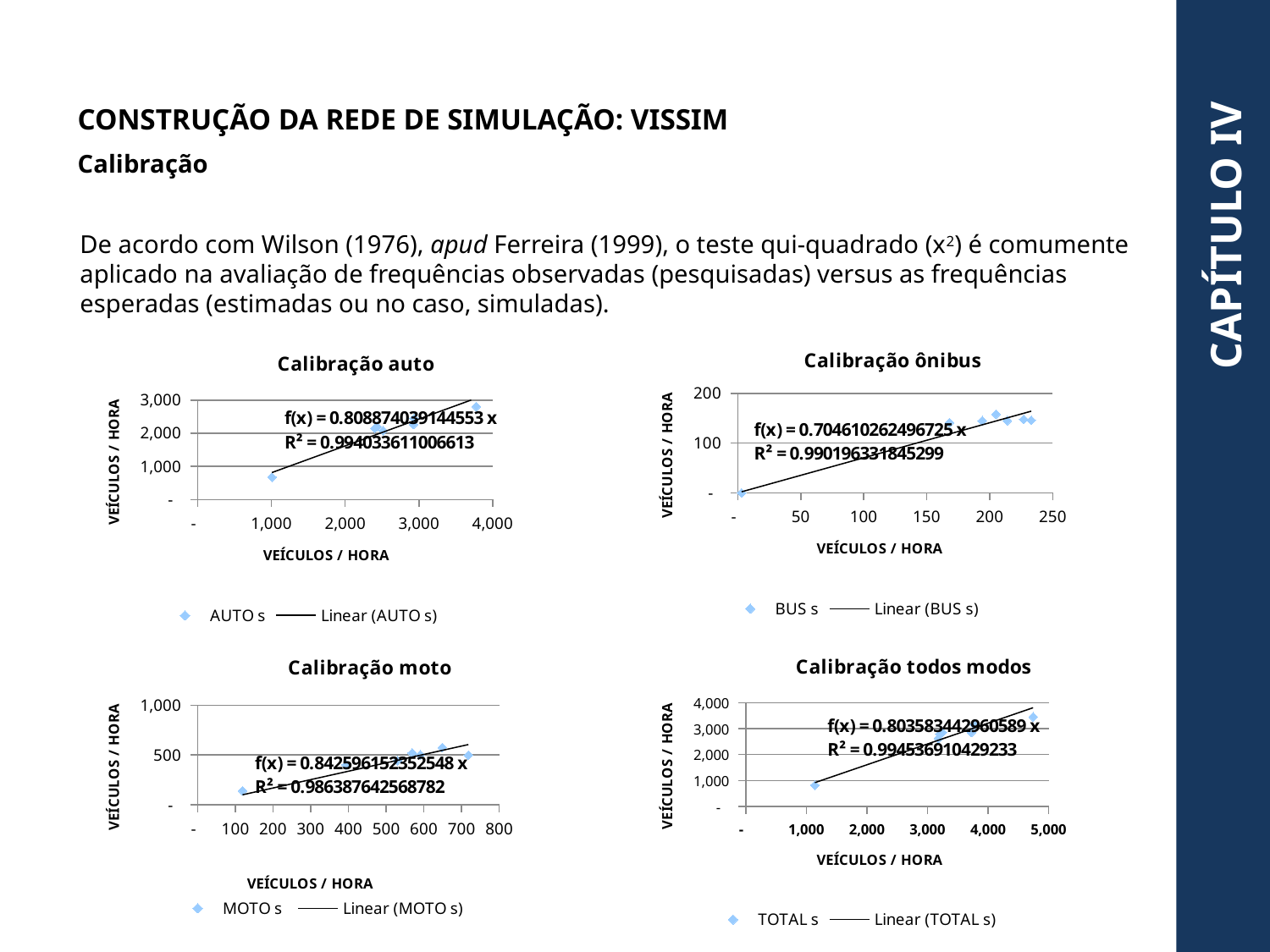
What kind of chart is "Calibração auto"? scatter chart with a linear trendline In the "Calibração todos modos" chart, is the y value of the highest point greater or less than 3,000? greater In the "Calibração auto" chart, what is the R² value printed on the chart? 0.994033611006613 Which of the four charts shows the highest R² value? Calibração todos modos In the "Calibração moto" chart, what is the R² value printed on the chart? 0.986387642568782 In the "Calibração ônibus" chart, what is the R² value printed on the chart? 0.990196331845299 In the "Calibração todos modos" chart, what is the trendline equation printed on the chart? f(x) = 0.803583442960589 x How many entries does the legend of the "Calibração ônibus" chart list? 2 In the "Calibração auto" chart, is the y value of the lowest point greater or less than 1,000? less What is the name of the scatter series in the legend of the "Calibração moto" chart? MOTO s How many charts are shown on the slide? 4 Which of the four charts shows the lowest R² value? Calibração moto